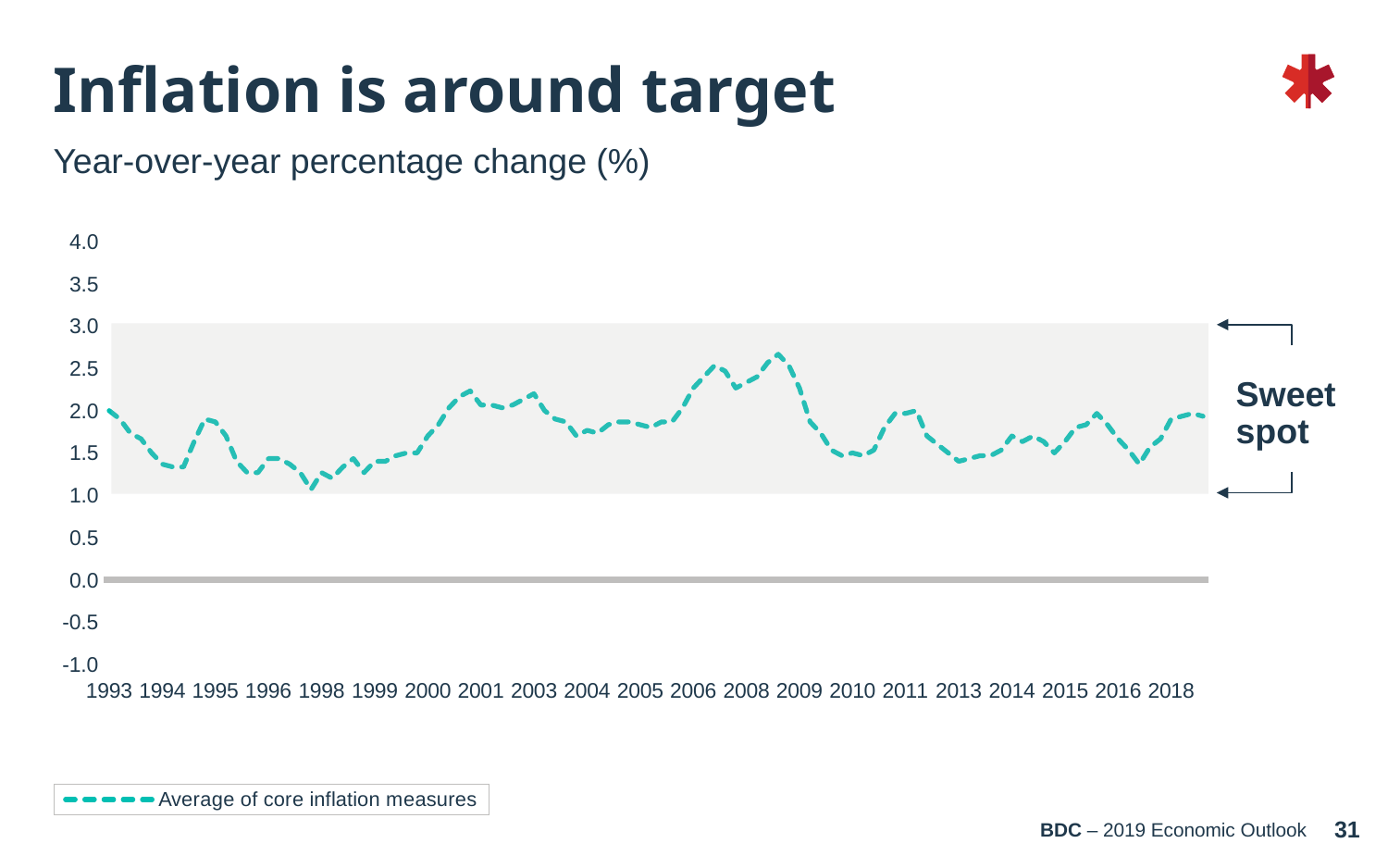
Is the peak value around 2008–2009 greater or less than 2.5? greater Is the value for 1998 greater or less than 1.5? less How many year labels are shown on the x axis? 21 Does the line rise or fall between 2009 and 2010? fall Is the value for 2010 greater or less than 2.0? less Does the line rise or fall between 1999 and 2001? rise What range of values is shaded and labelled as the "Sweet spot"? 1.0 to 3.0 What is the name of the series shown in the legend? Average of core inflation measures What kind of chart is shown on the slide? line chart How many series does the legend list? 1